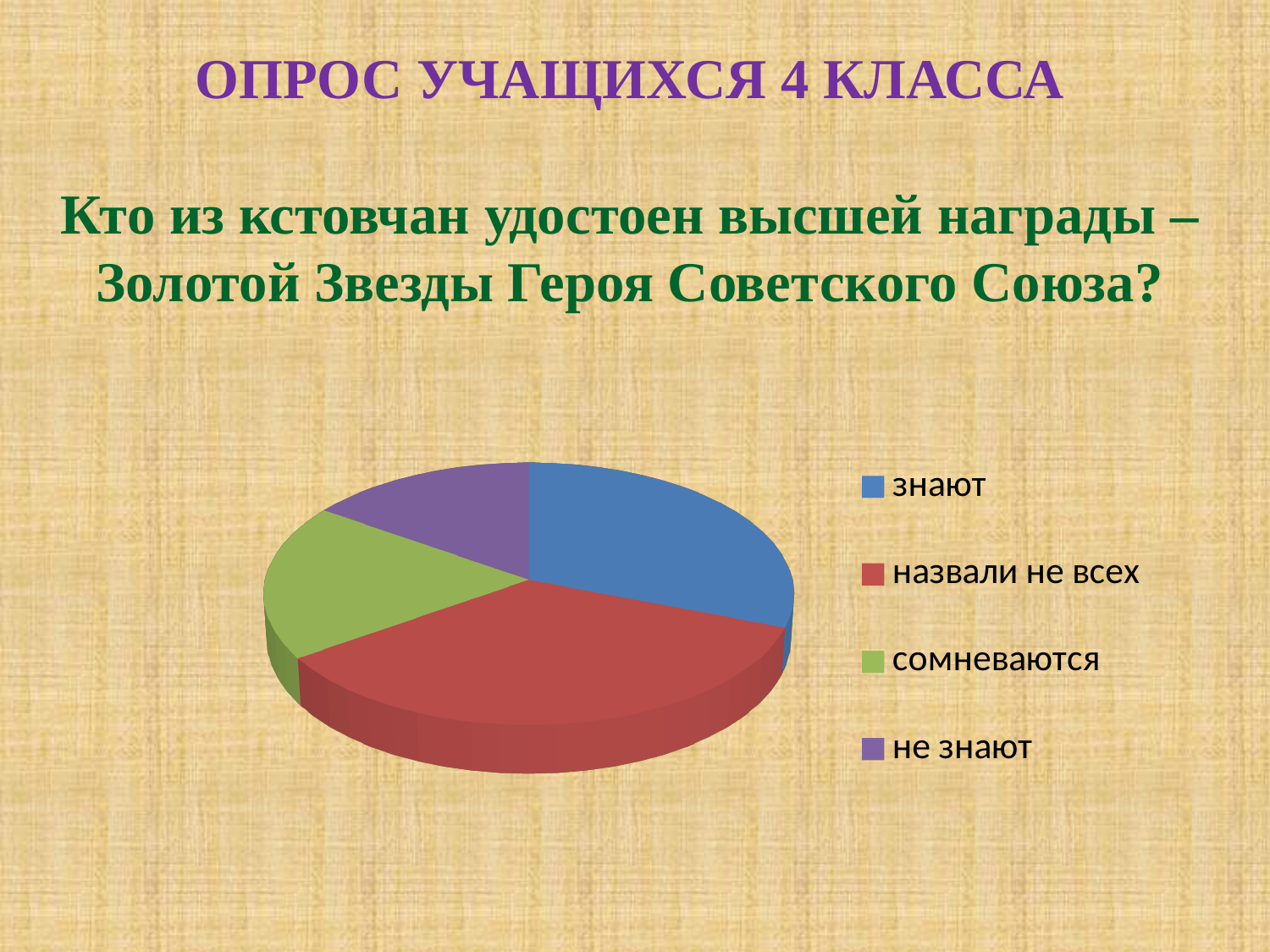
Which category has the largest slice of the pie? назвали не всех How many slices does the pie chart have? 4 How many entries does the legend list? 4 Which slice is larger, "знают" or "назвали не всех"? назвали не всех What colour is the "сомневаются" slice? green Which slice is larger, "знают" or "не знают"? знают Which slice is larger, "назвали не всех" or "сомневаются"? назвали не всех What kind of chart is shown on the slide? pie chart Which legend entry is shown in blue? знают